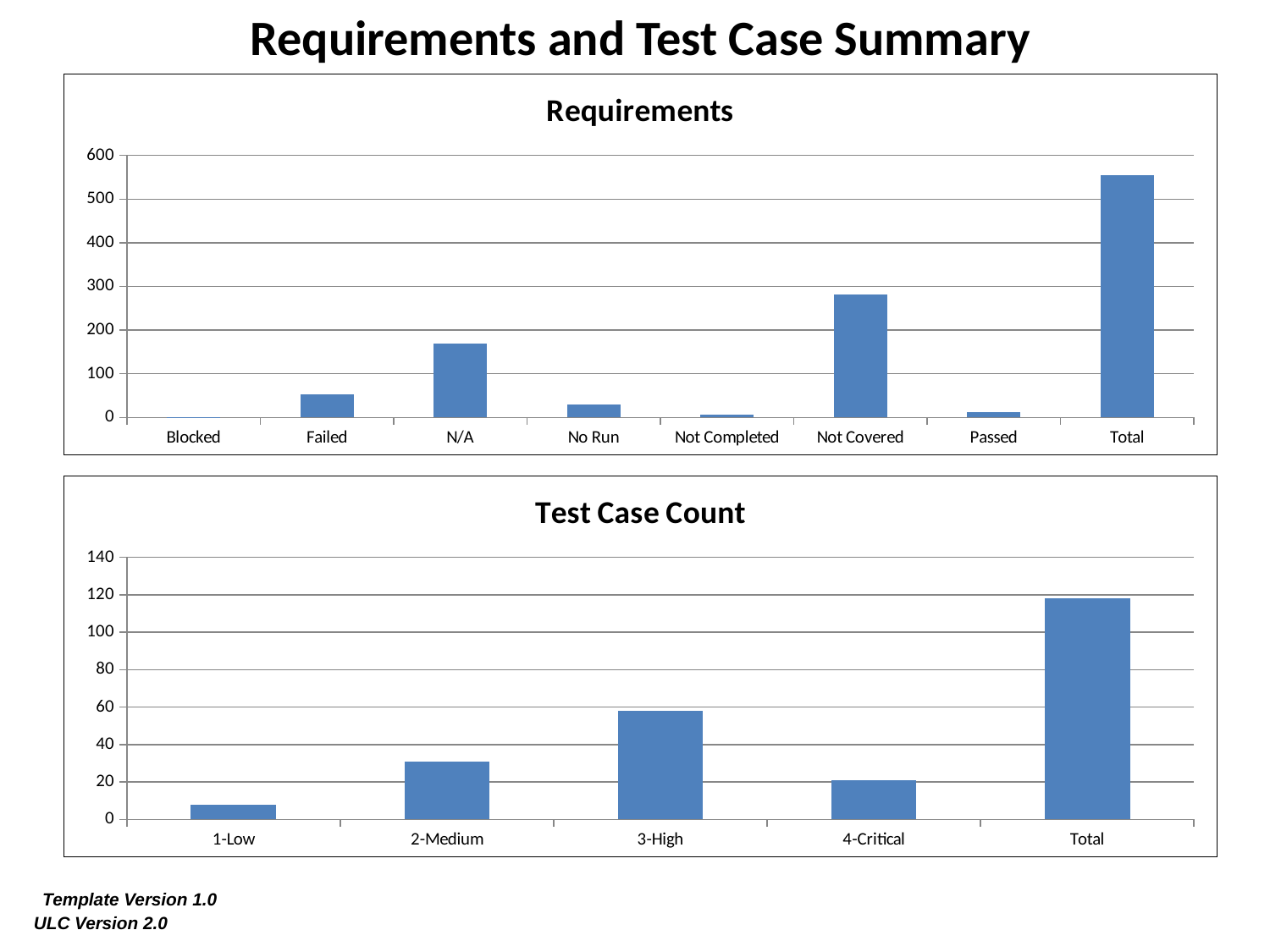
In the Test Case Count chart, which category has the lowest value? 1-Low In the Requirements chart, which is larger, the value for Failed or the value for N/A? N/A In the Test Case Count chart, which category has the highest value? Total What kind of chart is the Test Case Count chart? Bar chart In the Requirements chart, which category has the highest value? Total How many categories are shown on the x axis of the Requirements chart? 8 In the Requirements chart, which category has the lowest value? Blocked In the Requirements chart, is the value for N/A greater or less than 200? less In the Requirements chart, is the value for Not Covered greater or less than 200? greater In the Requirements chart, is the value for Total greater or less than 500? greater In the Test Case Count chart, which is larger, the value for 2-Medium or the value for 4-Critical? 2-Medium